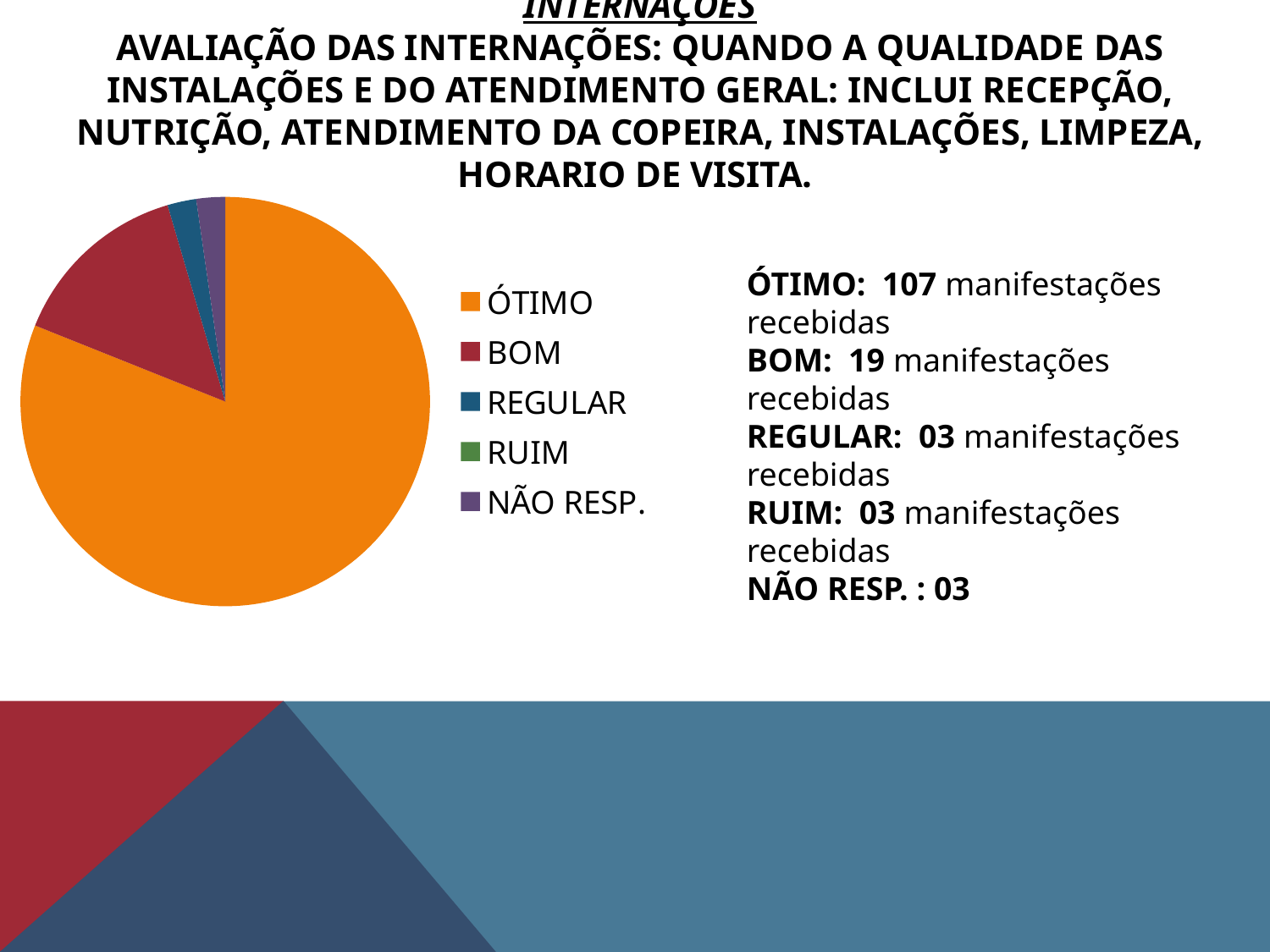
How many manifestações recebidas are reported for BOM? 19 What is the value given for NÃO RESP.? 03 How many manifestações recebidas are reported for RUIM? 03 Which is larger, the BOM slice or the REGULAR slice? BOM How many categories does the pie chart's legend list? 5 What kind of chart is shown on the slide? pie chart Which legend entry is listed second in the pie chart's legend? BOM What colour is the ÓTIMO slice in the pie chart? orange What is the difference between the ÓTIMO and BOM counts? 88 Which category has the largest slice of the pie chart? ÓTIMO How many manifestações recebidas are reported for ÓTIMO? 107 How many manifestações recebidas are reported for REGULAR? 03